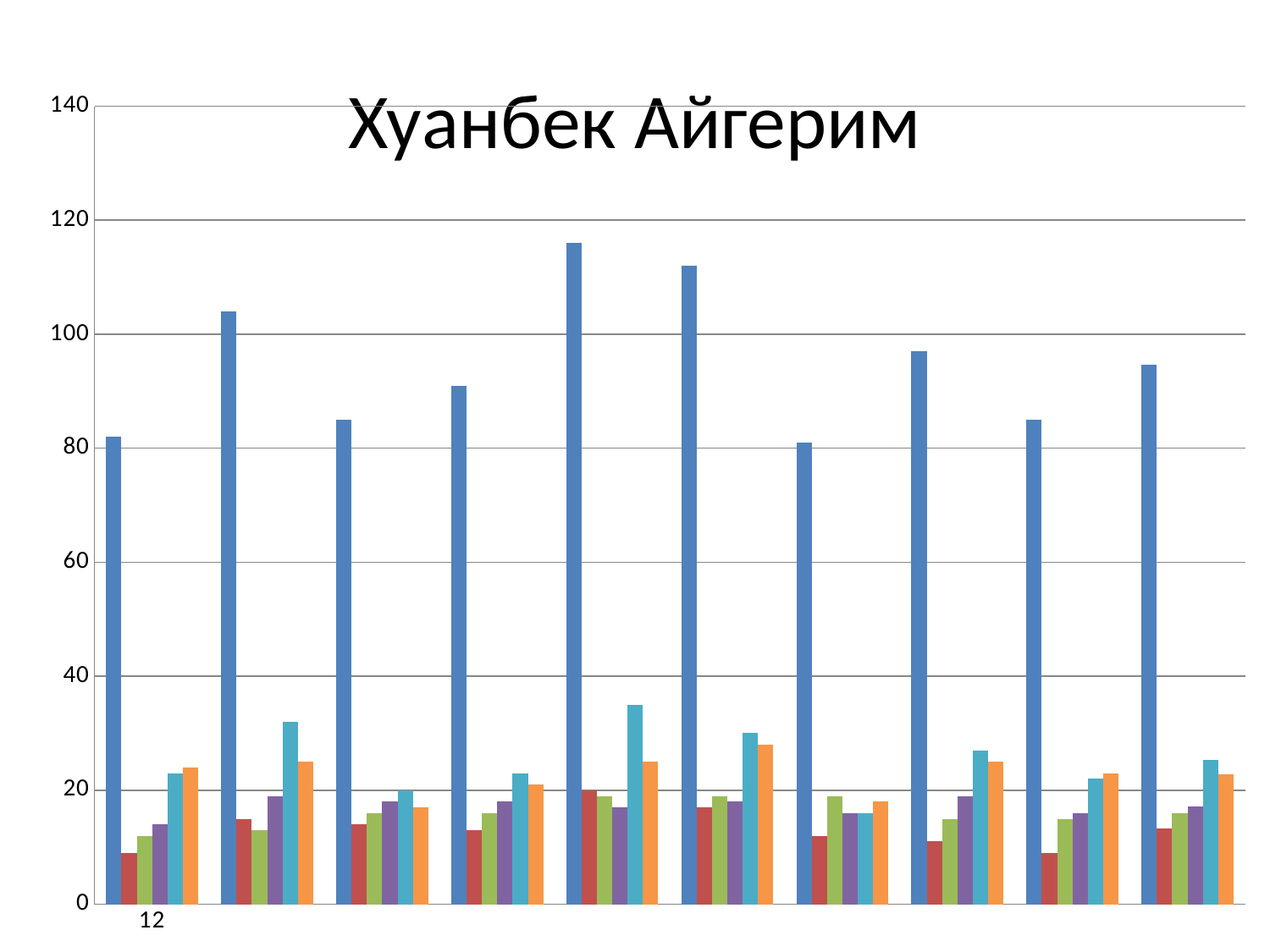
Is the value of the blue bar in the group labeled 12 greater or less than 100? less What colour are the tallest bars in every group of the chart? blue In the group labeled 12, which is larger: the orange bar or the red bar? the orange bar In the group labeled 12, which bar is the shortest? the red bar In the group labeled 12, which bar is the tallest? the blue bar What kind of chart is shown on the slide? bar chart What is the title of the chart? Хуанбек Айгерим How many groups of bars are plotted in the chart? 10 Is the value of the red bar in the group labeled 12 greater or less than 20? less Is the value of the orange bar in the group labeled 12 greater or less than 20? greater How many bars are in the group labeled 12? 6